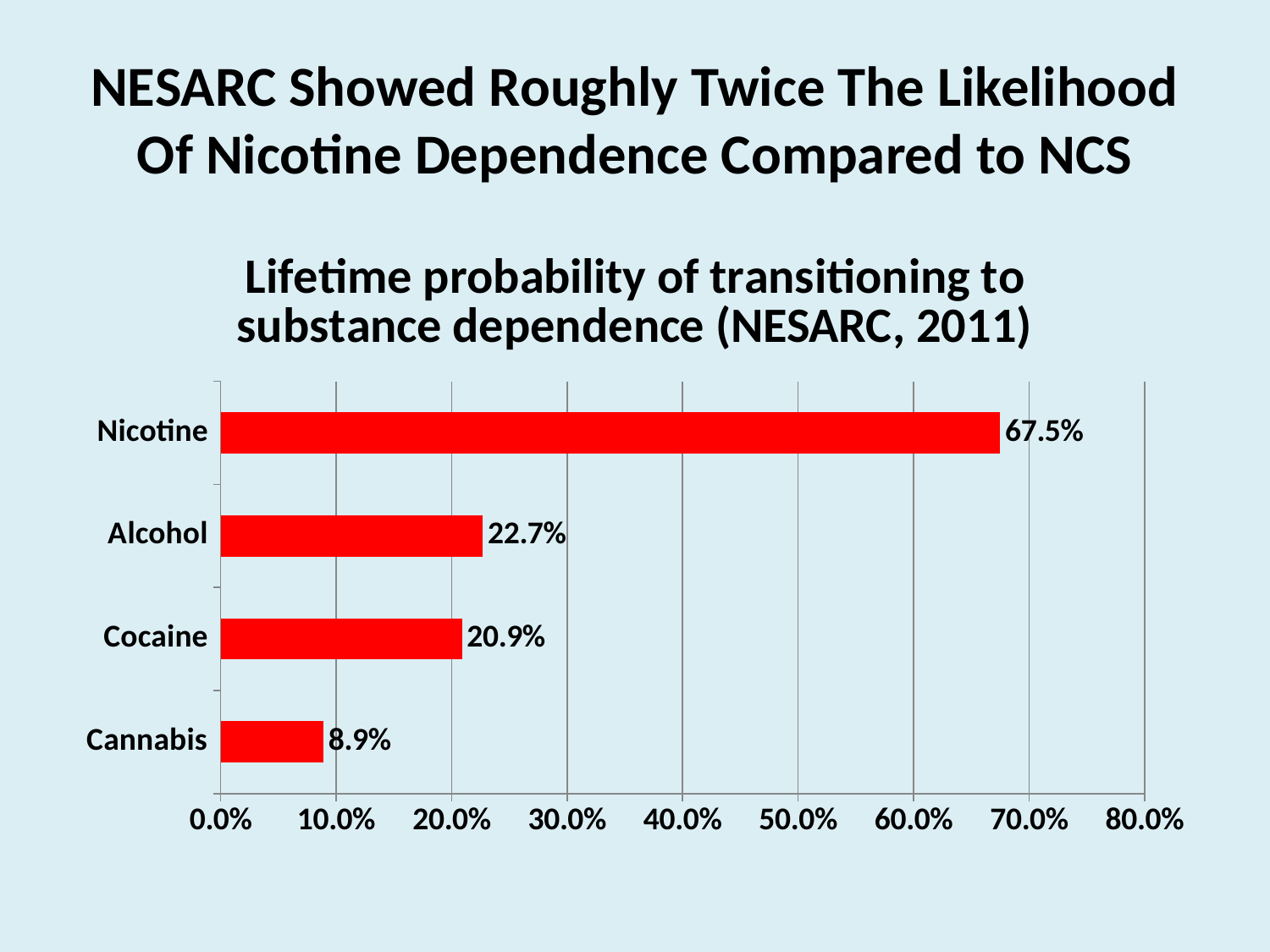
What type of chart is shown on the slide? Bar chart What is the difference between the values for Nicotine and Alcohol? 44.8% How many substances are shown in the chart? 4 Which substance has the lowest lifetime probability of transitioning to dependence? Cannabis What is the lifetime probability of transitioning to dependence for Cocaine? 20.9% Is the value for Nicotine greater or less than 60.0%? greater Which substance has the highest lifetime probability of transitioning to dependence? Nicotine What is the lifetime probability of transitioning to dependence for Cannabis? 8.9% What is the lifetime probability of transitioning to dependence for Alcohol? 22.7% Which has a higher lifetime probability of dependence, Alcohol or Cocaine? Alcohol What is the lifetime probability of transitioning to dependence for Nicotine? 67.5% What is the difference between the values for Cocaine and Cannabis? 12.0%